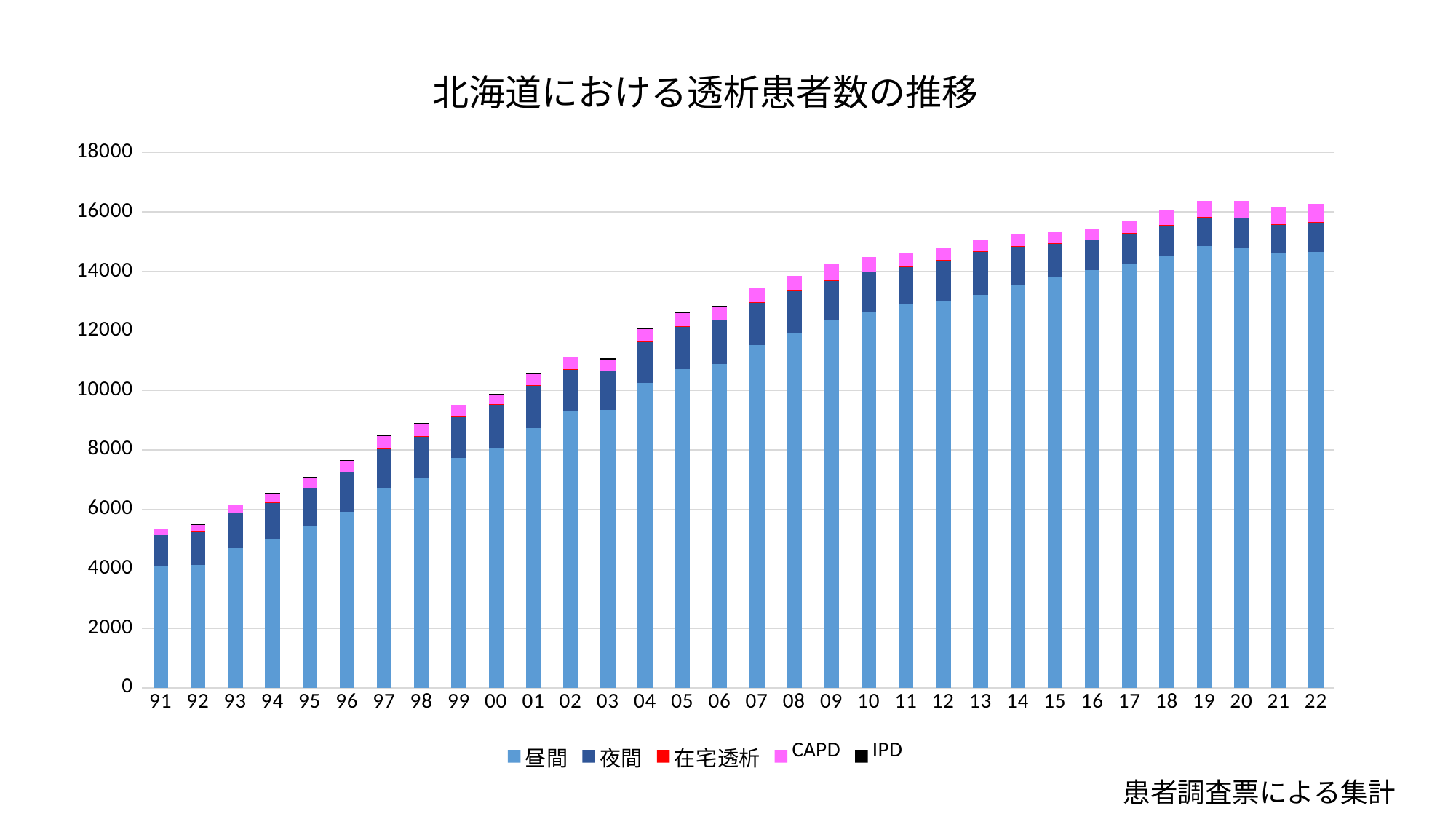
Is the total bar for 91 greater or less than 6000? less Which year has the larger 昼間 value, 05 or 15? 15 Is the total bar for 22 greater or less than 16000? greater Do the total bar heights generally rise or fall from 91 to 22? rise Is the total bar for 10 greater or less than 14000? greater Which year has the lowest total bar? 91 What kind of chart is shown on the slide? stacked bar chart Which year has the larger total bar, 91 or 22? 22 How many years (bars) are shown on the x axis? 32 How many series does the legend list? 5 What is the title of the chart? 北海道における透析患者数の推移